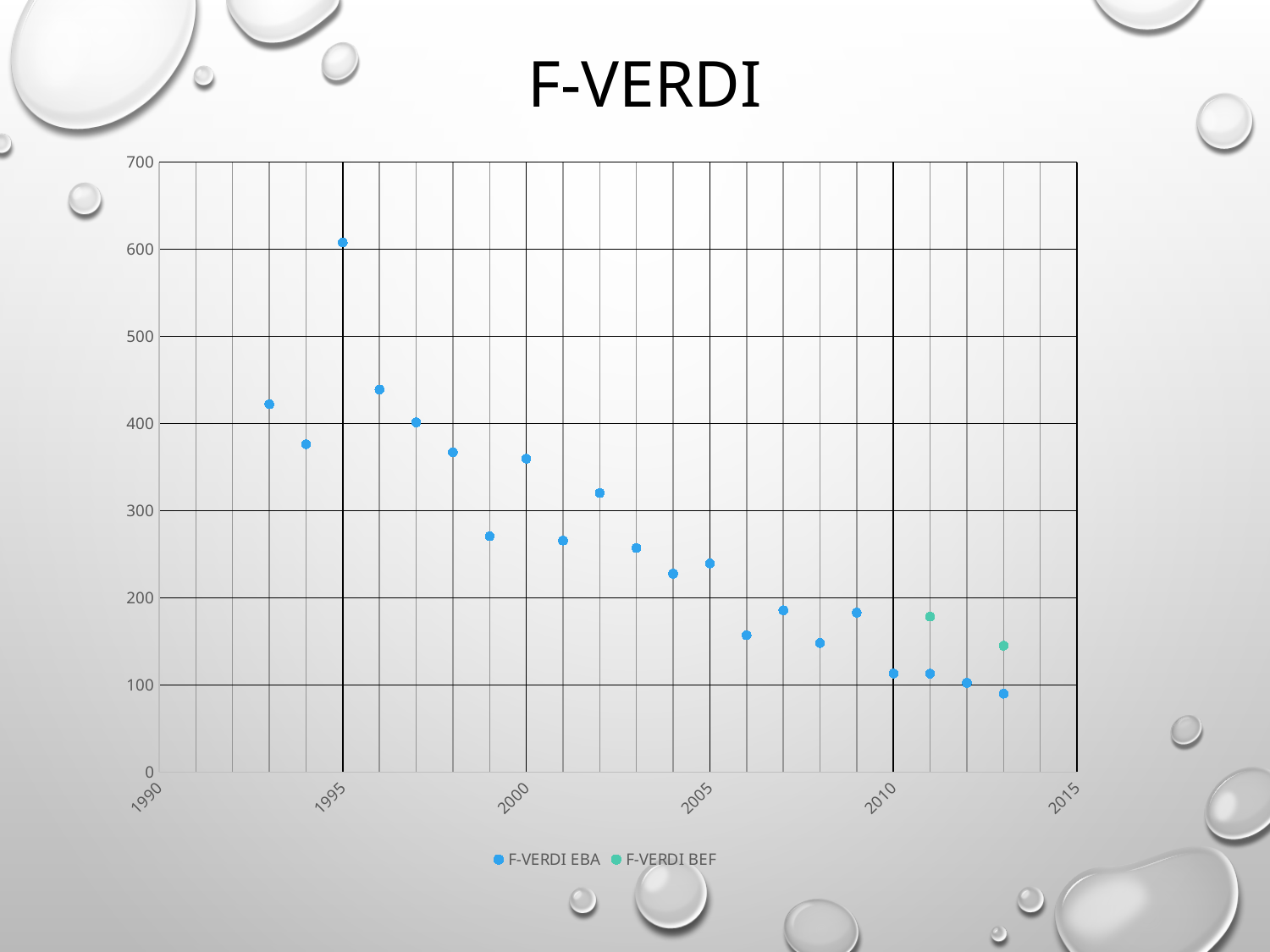
How many series does the legend list? 2 In 2011, which series has the larger value, F-VERDI EBA or F-VERDI BEF? F-VERDI BEF Is the F-VERDI BEF value for 2011 greater or less than 200? less Do the F-VERDI EBA values generally rise or fall from 1993 to 2013? fall Is the F-VERDI EBA value for 1995 greater or less than 500? greater In which year does the F-VERDI EBA series reach its highest value? 1995 What kind of chart is shown on the slide? scatter chart In which year does the F-VERDI EBA series reach its lowest value? 2013 What are the two series named in the legend? F-VERDI EBA and F-VERDI BEF Is the F-VERDI EBA value for 2013 greater or less than 100? less What is the title of the chart? F-VERDI How many data points are plotted for the F-VERDI BEF series? 2